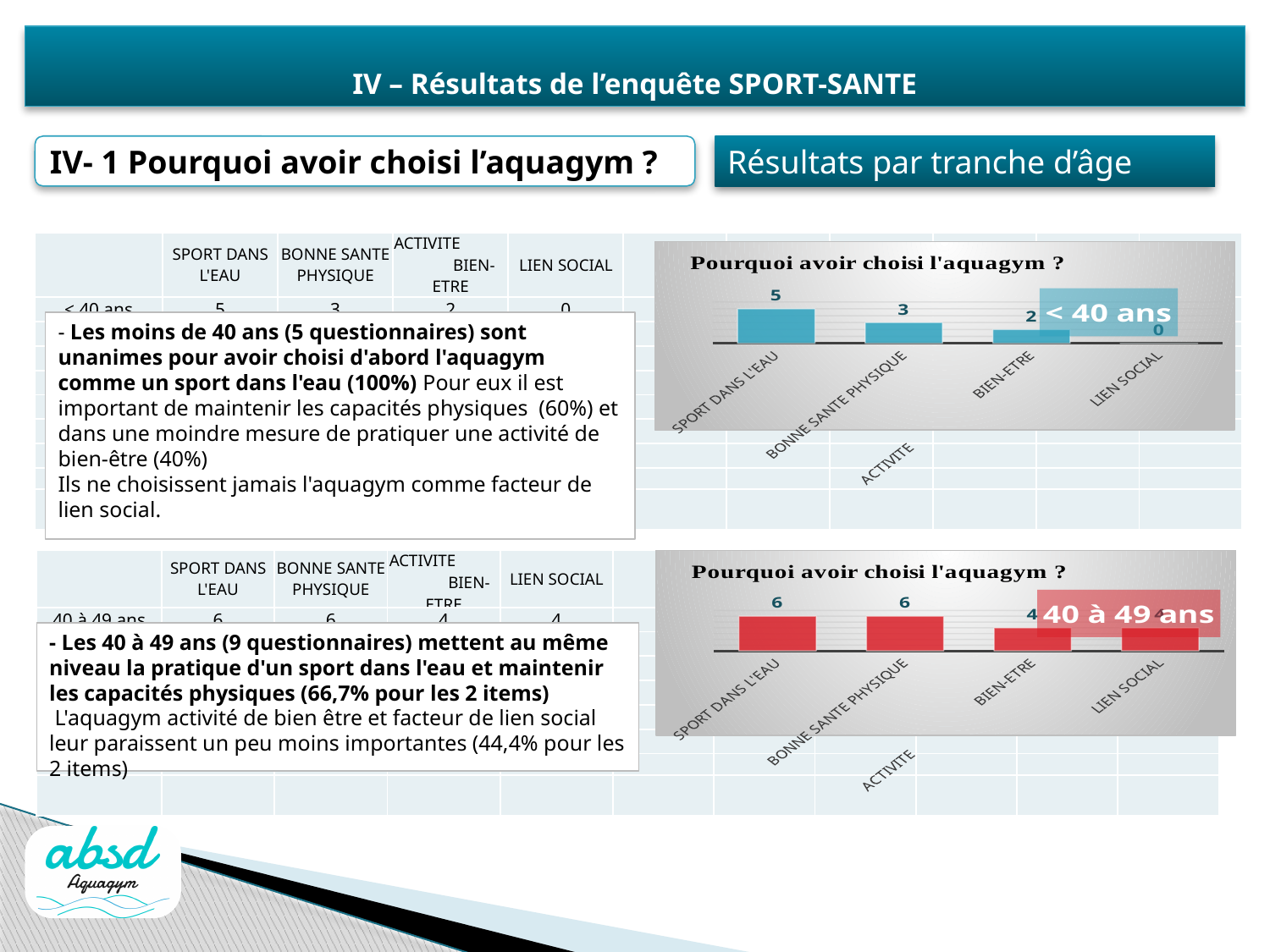
In the top chart (< 40 ans), which category has the lowest value? LIEN SOCIAL In the bottom chart (40 à 49 ans), what is the value for ACTIVITE BIEN-ETRE? 4 In the top chart (< 40 ans), what is the value for BONNE SANTE PHYSIQUE? 3 In the bottom chart (40 à 49 ans), which is larger, SPORT DANS L'EAU or ACTIVITE BIEN-ETRE? SPORT DANS L'EAU How many categories are shown in the top chart (< 40 ans)? 4 What type of chart is the bottom chart (40 à 49 ans)? Bar chart In the top chart (< 40 ans), what is the value for SPORT DANS L'EAU? 5 In the top chart (< 40 ans), what is the value for LIEN SOCIAL? 0 In the bottom chart (40 à 49 ans), what is the value for SPORT DANS L'EAU? 6 In the top chart (< 40 ans), what is the difference between SPORT DANS L'EAU and ACTIVITE BIEN-ETRE? 3 In the top chart (< 40 ans), which category has the highest value? SPORT DANS L'EAU What is the title of the top chart? Pourquoi avoir choisi l'aquagym ?